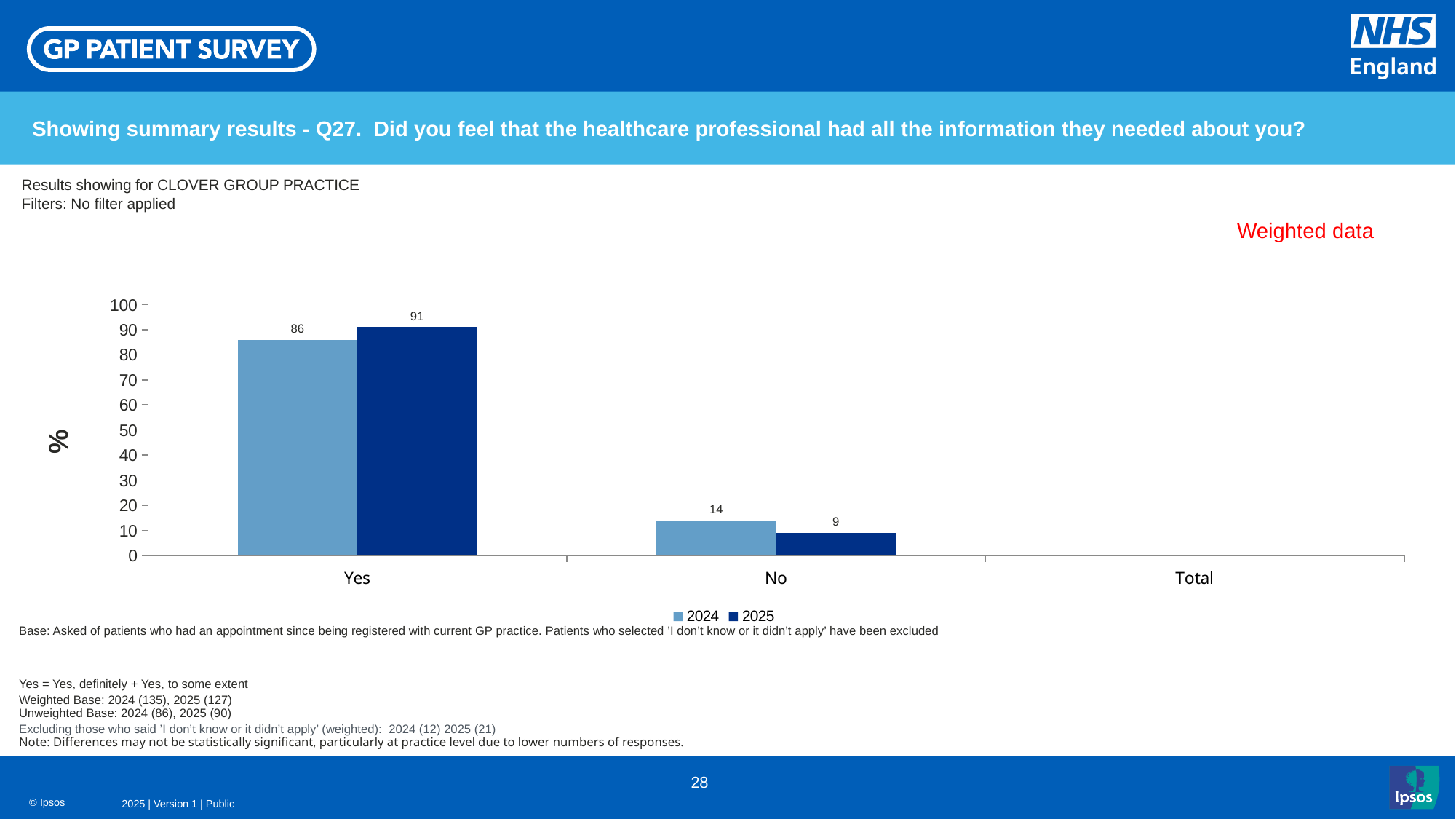
Which is larger for No: the 2024 value or the 2025 value? 2024 How many series does the legend list? 2 Which category has the highest 2025 value? Yes What is the 2024 value for Yes? 86 What is the label on the vertical axis? % What is the 2024 value for No? 14 What is the difference between the 2025 and 2024 values for Yes? 5 What is the difference between the 2024 and 2025 values for No? 5 What is the 2025 value for Yes? 91 What is the 2025 value for No? 9 Which category has the lowest 2024 value? No What kind of chart is shown on the slide? Bar chart